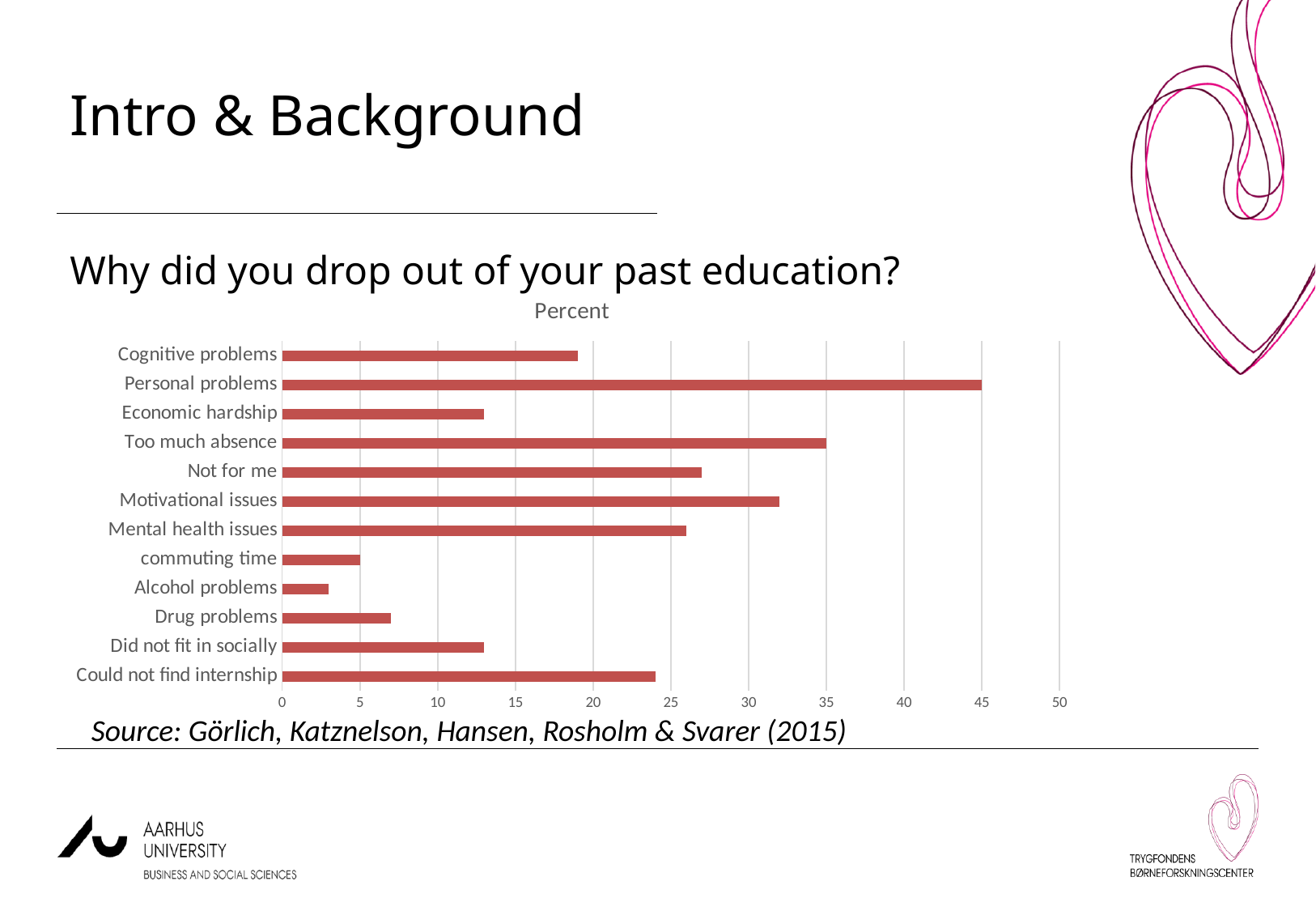
Which reason has the highest percentage in the chart? Personal problems Which is larger, the value for Motivational issues or the value for Not for me? Motivational issues What is the value for Personal problems? 45 Is the value for Mental health issues greater or less than 25? greater Is the value for Drug problems greater or less than 5? greater Is the value for Could not find internship greater or less than 25? less How many categories (reasons) are plotted in the chart? 12 What is the title shown above the chart's plot area? Percent Which reason has the lowest percentage in the chart? Alcohol problems What is the value for Too much absence? 35 What kind of chart is shown on the slide? bar chart